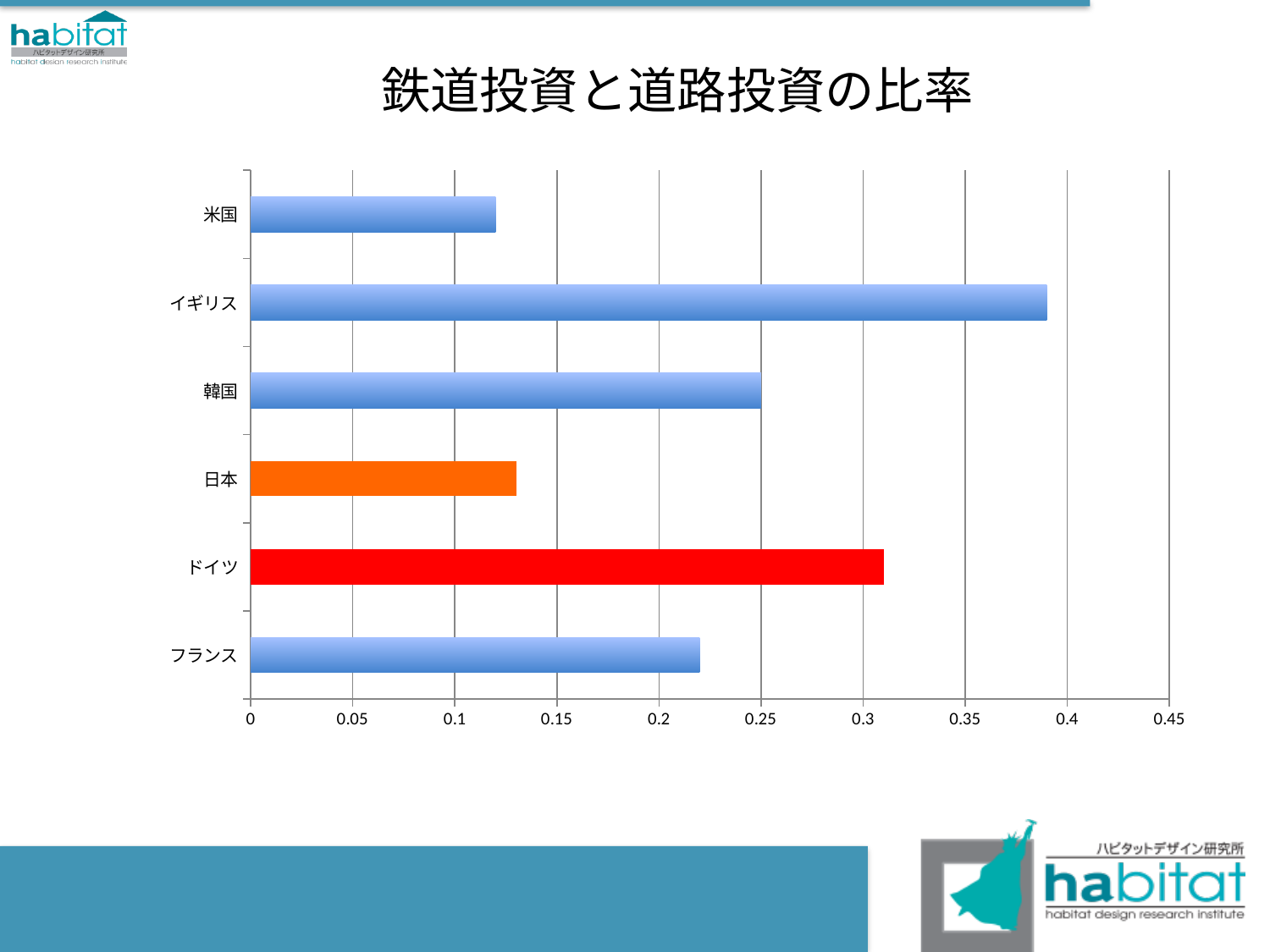
Is the value for 米国 greater or less than 0.15? less How many countries are shown in the chart? 6 Which has a larger value, ドイツ or 韓国? ドイツ Which has a larger value, フランス or 日本? フランス Is the value for イギリス greater or less than 0.35? greater Is the value for ドイツ greater or less than 0.3? greater What colour is the bar for ドイツ? red What is the value for 韓国? 0.25 Which country has the highest value in the chart? イギリス What kind of chart is shown on the slide? bar chart What is the title of the chart? 鉄道投資と道路投資の比率